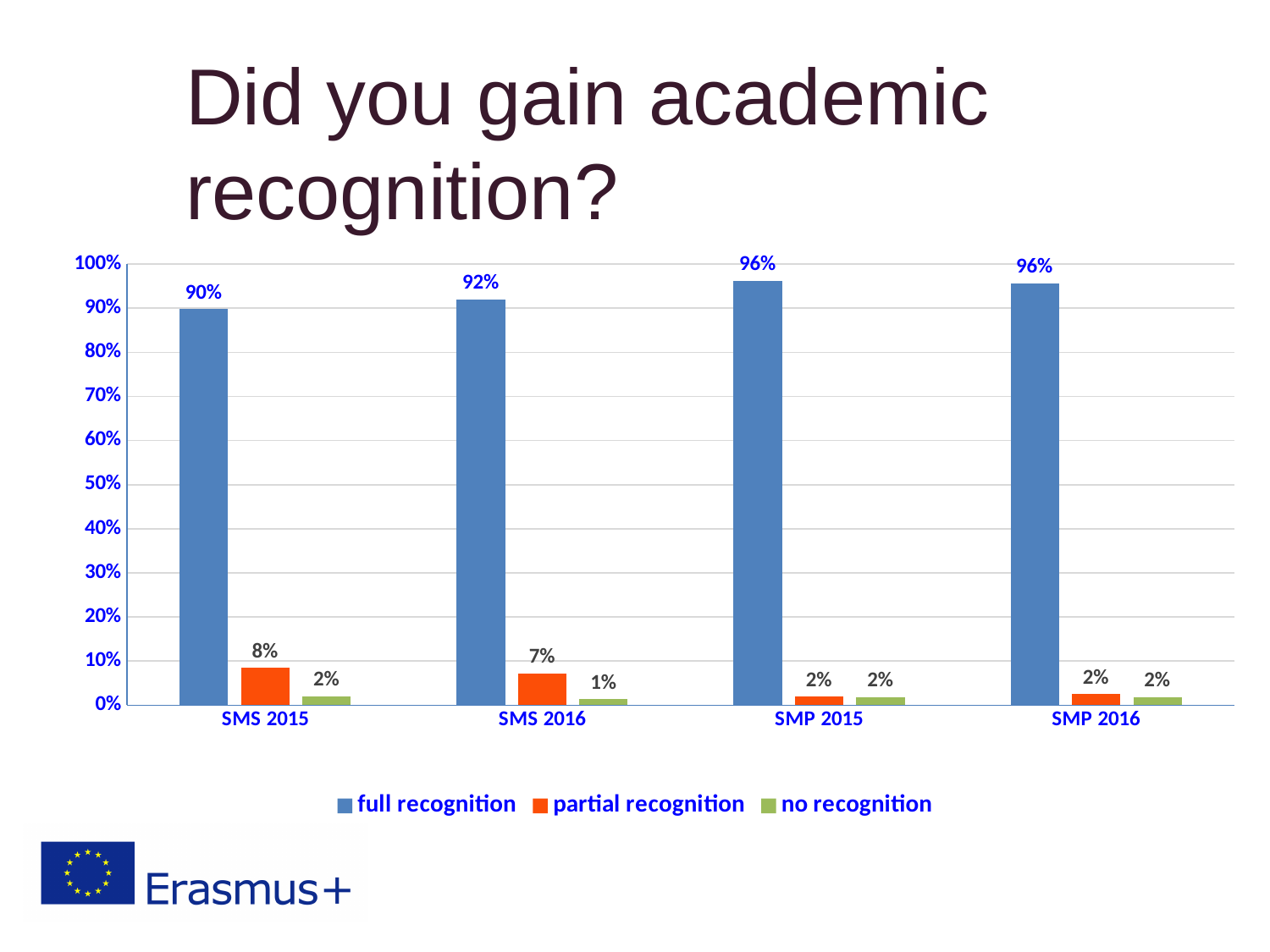
What is the partial recognition value for SMS 2016? 7% How many series does the legend list? 3 Which category has the lowest full recognition value? SMS 2015 What is the full recognition value for SMS 2015? 90% What is the partial recognition value for SMP 2015? 2% What is the no recognition value for SMS 2016? 1% Which series is shown in orange? partial recognition What kind of chart is shown on the slide? Bar chart Which is larger, the partial recognition value for SMS 2015 or for SMP 2016? SMS 2015 How many categories are shown on the x axis? 4 What is the difference between the full recognition values for SMS 2016 and SMS 2015? 2% Which category has the highest partial recognition value? SMS 2015